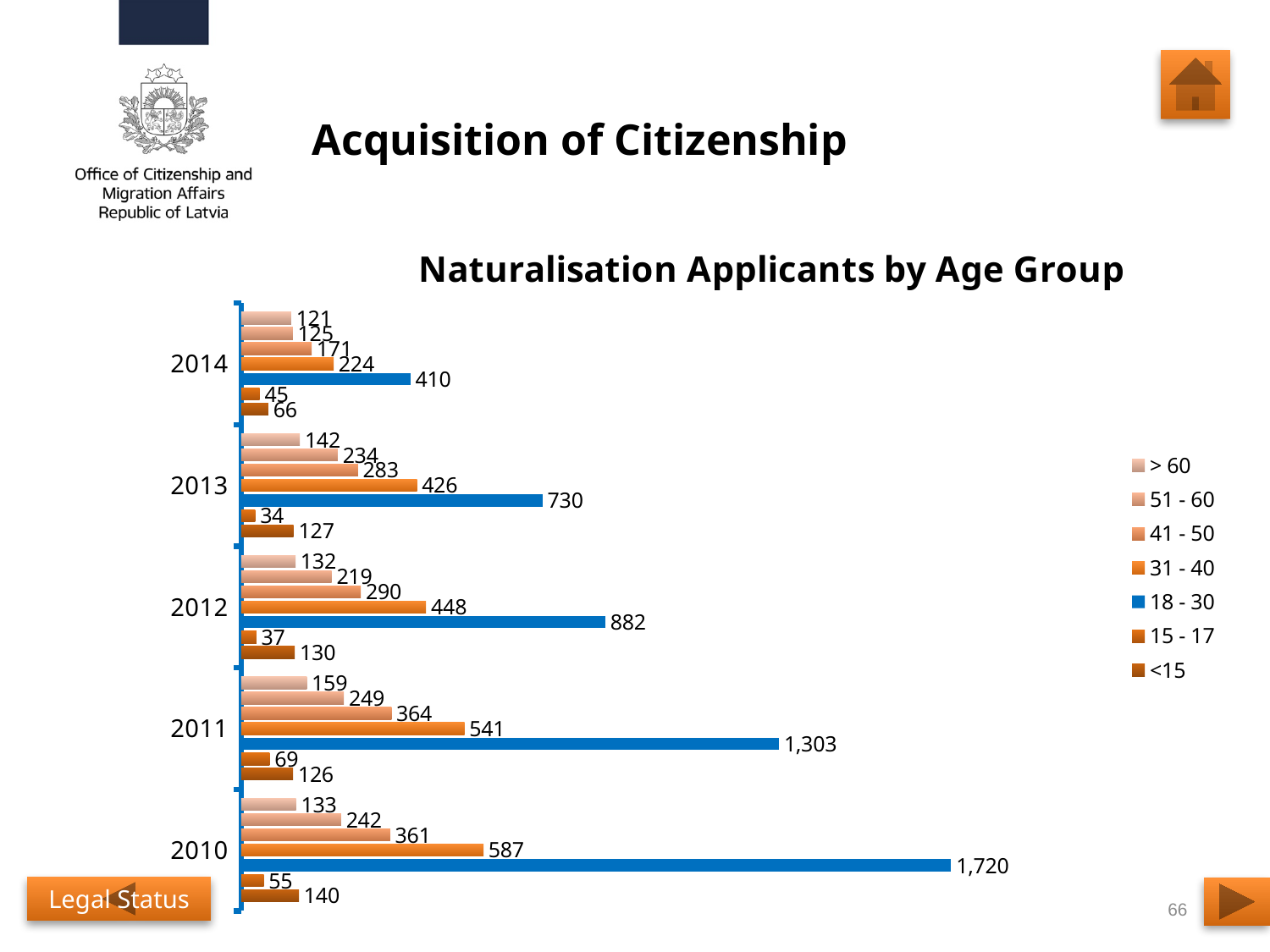
How many age groups does the legend list? 7 What kind of chart is shown on the slide? Bar chart What is the value for the 31 - 40 age group in 2013? 426 Which age group has the lowest value in 2013? 15 - 17 What is the value for the 18 - 30 age group in 2010? 1,720 What is the value for the <15 age group in 2012? 130 Which year has the highest value for the 18 - 30 age group? 2010 How many years are shown on the chart? 5 What is the title of the chart? Naturalisation Applicants by Age Group Does the value for the 18 - 30 age group rise or fall from 2010 to 2014? Fall What is the difference between the 18 - 30 values for 2011 and 2012? 421 Which is larger: the 41 - 50 value in 2011 or the 41 - 50 value in 2010? 2011